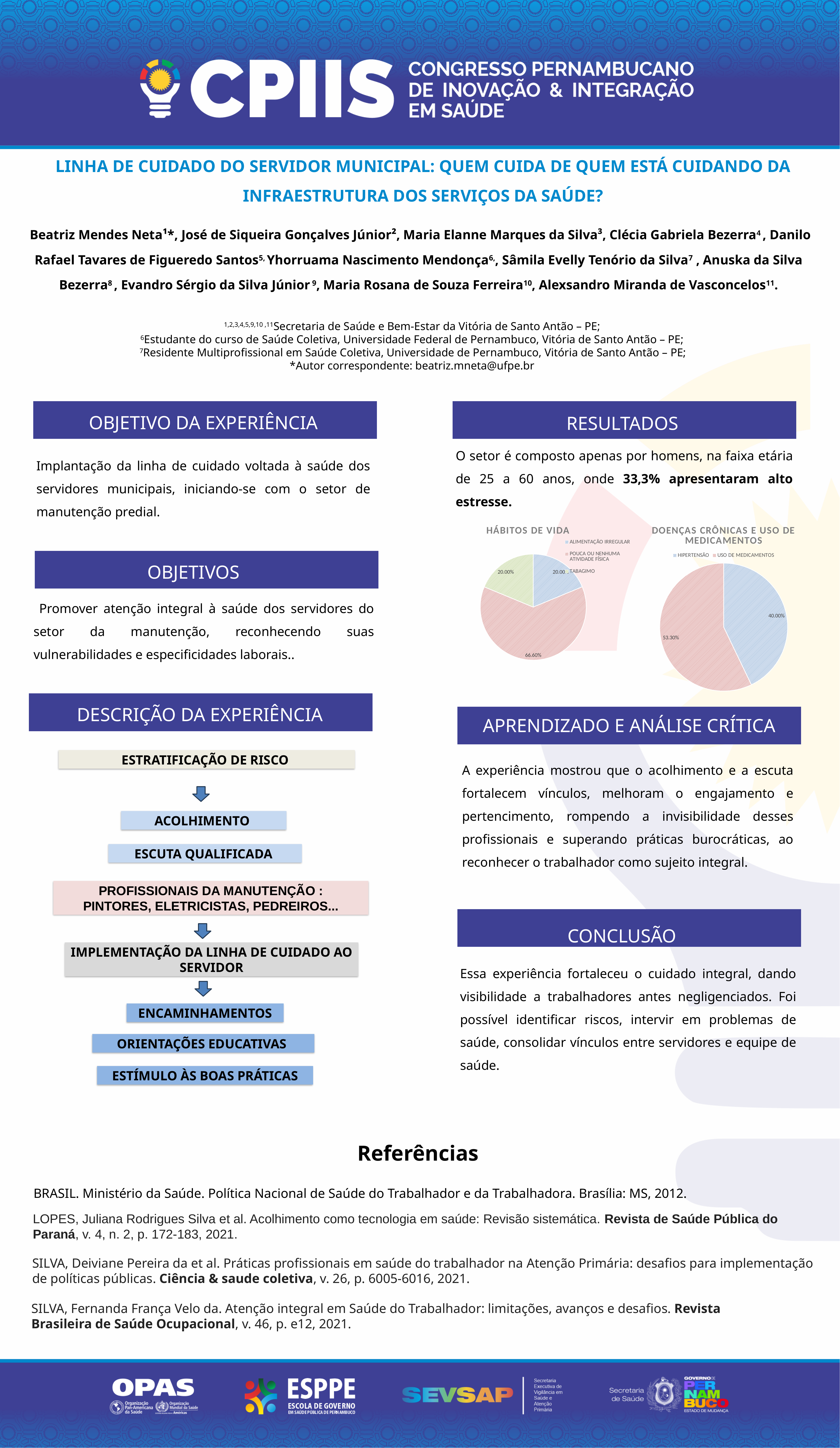
How many categories does the legend of the 'HÁBITOS DE VIDA' chart list? 3 In the 'HÁBITOS DE VIDA' chart, what is the value for TABAGISMO? 20.00% In the 'DOENÇAS CRÔNICAS E USO DE MEDICAMENTOS' chart, what is the value for USO DE MEDICAMENTOS? 53.30% What kind of chart is the 'DOENÇAS CRÔNICAS E USO DE MEDICAMENTOS' chart? pie chart What is the title of the pie chart on the left in the RESULTADOS section? HÁBITOS DE VIDA In the 'DOENÇAS CRÔNICAS E USO DE MEDICAMENTOS' chart, what is the difference between USO DE MEDICAMENTOS and HIPERTENSÃO? 13.30% How many categories does the legend of the 'DOENÇAS CRÔNICAS E USO DE MEDICAMENTOS' chart list? 2 In the 'DOENÇAS CRÔNICAS E USO DE MEDICAMENTOS' chart, what is the value for HIPERTENSÃO? 40.00% In the 'DOENÇAS CRÔNICAS E USO DE MEDICAMENTOS' chart, which is larger, HIPERTENSÃO or USO DE MEDICAMENTOS? USO DE MEDICAMENTOS What kind of chart is the 'HÁBITOS DE VIDA' chart? pie chart In the 'HÁBITOS DE VIDA' chart, what is the value for POUCA OU NENHUMA ATIVIDADE FÍSICA? 66.60% In the 'HÁBITOS DE VIDA' chart, which category has the largest slice? POUCA OU NENHUMA ATIVIDADE FÍSICA